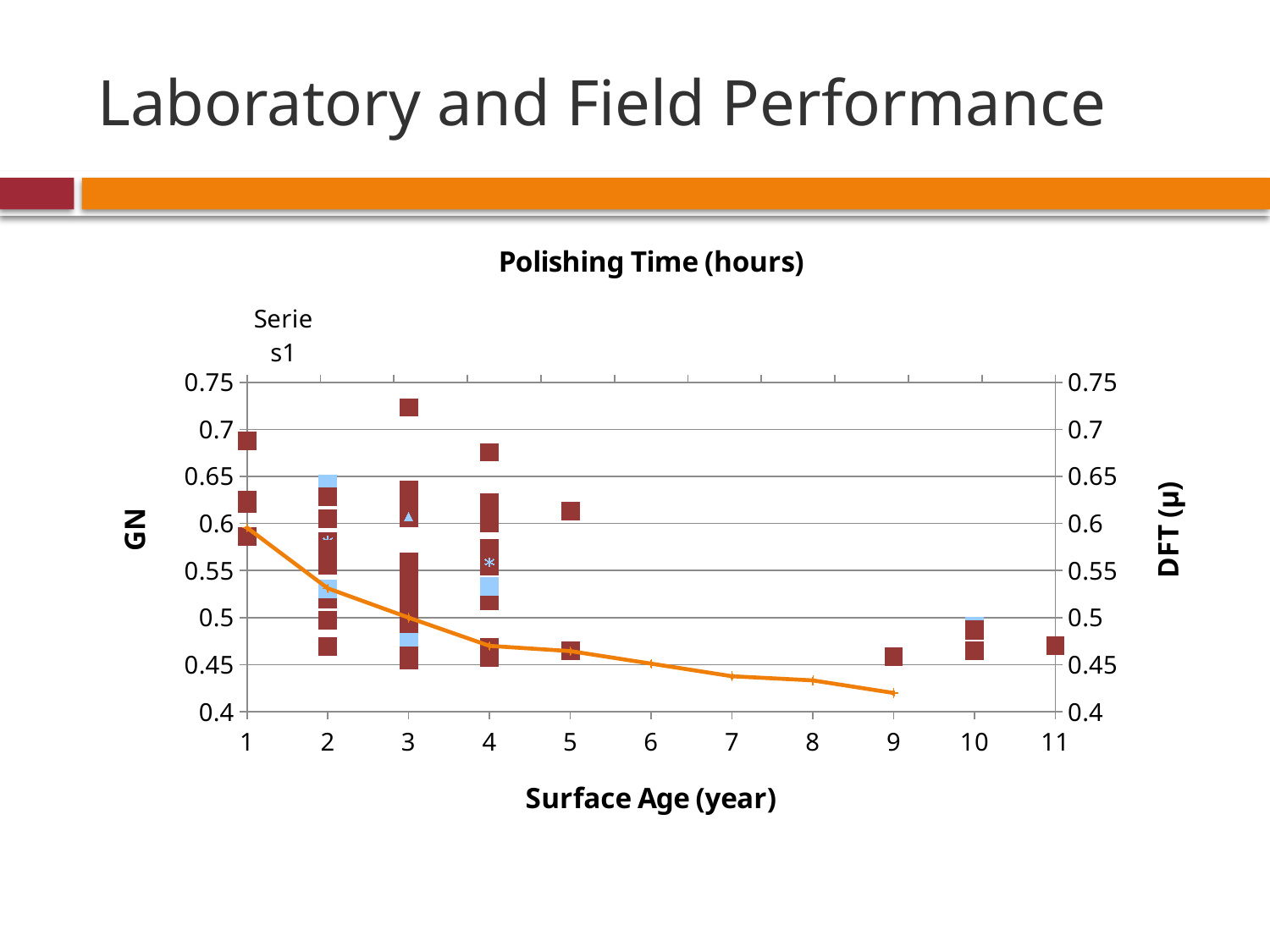
Is the value of the orange line at Surface Age 2 greater or less than 0.5? greater What is the title of the chart? Polishing Time (hours) Is the value of the orange line at Surface Age 9 greater or less than 0.45? less Is the square marker at Surface Age 11 greater or less than 0.5? less What is the label of the horizontal axis? Surface Age (year) How many series does the legend list? 1 What kind of chart is shown on the slide? scatter chart with a line At which Surface Age does the orange line reach its lowest value? 9 At which Surface Age is the highest square marker plotted? 3 Does the orange line rise or fall as Surface Age increases? fall How many tick labels are shown on the horizontal axis? 11